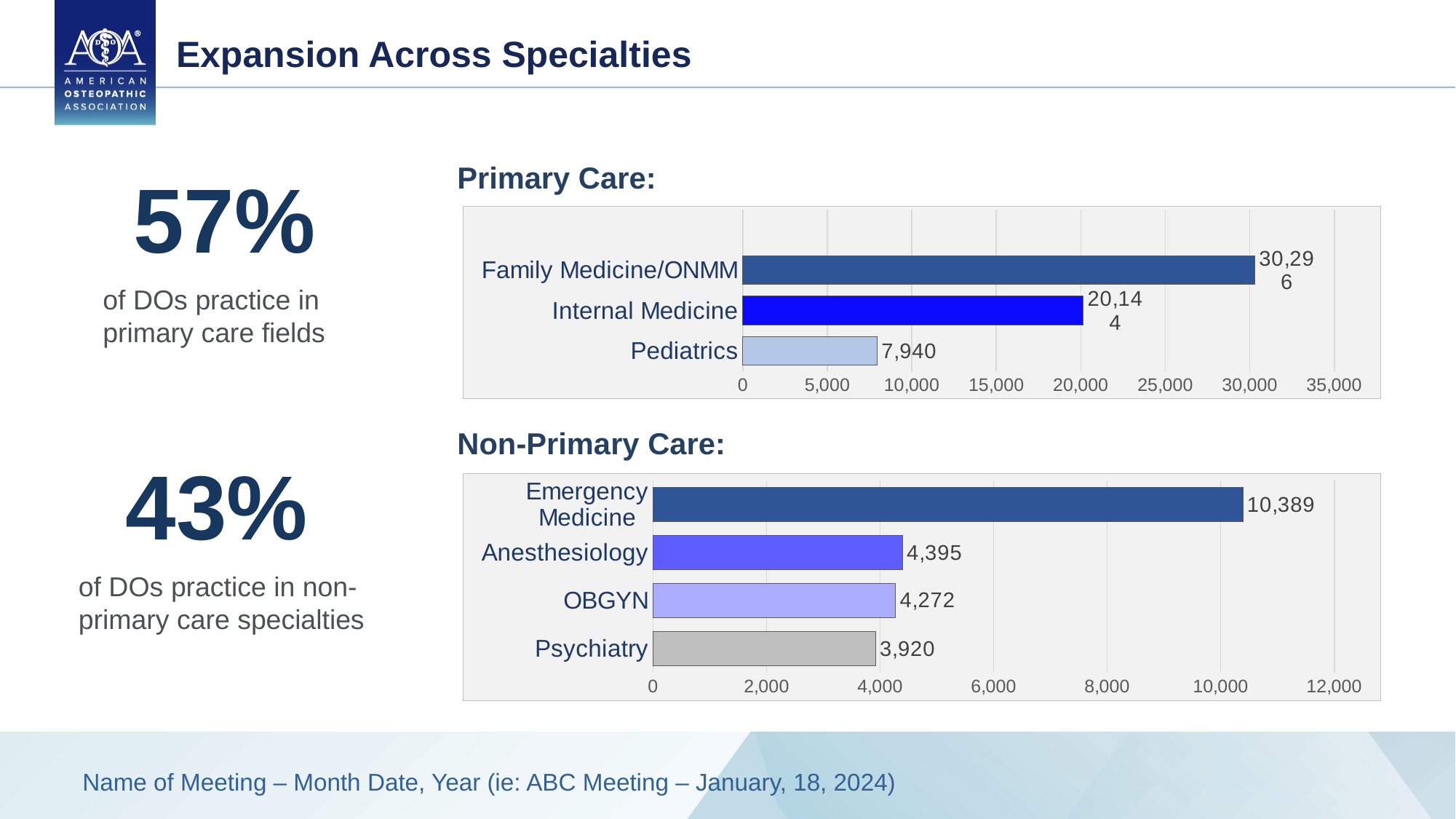
In the Non-Primary Care chart, what is the difference between Anesthesiology and OBGYN? 123 In the Non-Primary Care chart, is the value for Emergency Medicine greater or less than 10,000? greater In the Non-Primary Care chart, which category has the lowest value? Psychiatry In the Primary Care chart, what is the difference between Family Medicine/ONMM and Internal Medicine? 10,152 In the Non-Primary Care chart, how many categories are shown? 4 In the Primary Care chart, what is the value for Pediatrics? 7,940 In the Non-Primary Care chart, what is the value for Psychiatry? 3,920 In the Primary Care chart, which category has the highest value? Family Medicine/ONMM In the Primary Care chart, what is the value for Family Medicine/ONMM? 30,296 What type of chart is the Non-Primary Care chart? Bar chart In the Primary Care chart, how many categories are shown? 3 In the Non-Primary Care chart, what is the value for Emergency Medicine? 10,389